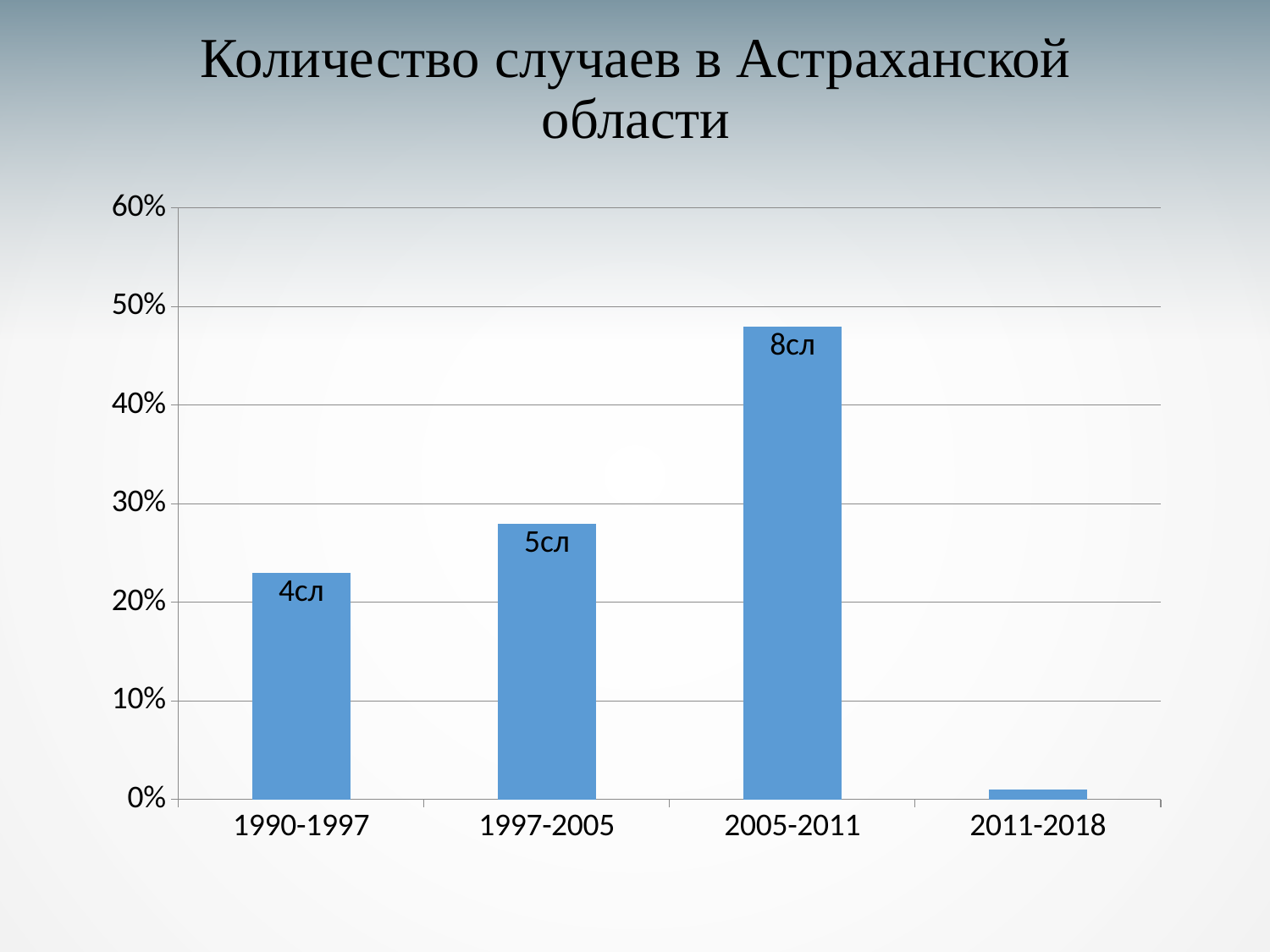
Is the value for 1990-1997 greater or less than 30%? less How many categories (periods) are shown on the x axis? 4 What data label is printed on the bar for 2005-2011? 8сл What is the title of the chart? Количество случаев в Астраханской области Which period has the highest bar? 2005-2011 Which period has the lowest bar? 2011-2018 Is the value for 2011-2018 greater or less than 10%? less Is the value for 2005-2011 greater or less than 40%? greater What data label is printed on the bar for 1990-1997? 4сл What data label is printed on the bar for 1997-2005? 5сл What kind of chart is shown on the slide? bar chart Which bar is taller, 1997-2005 or 1990-1997? 1997-2005